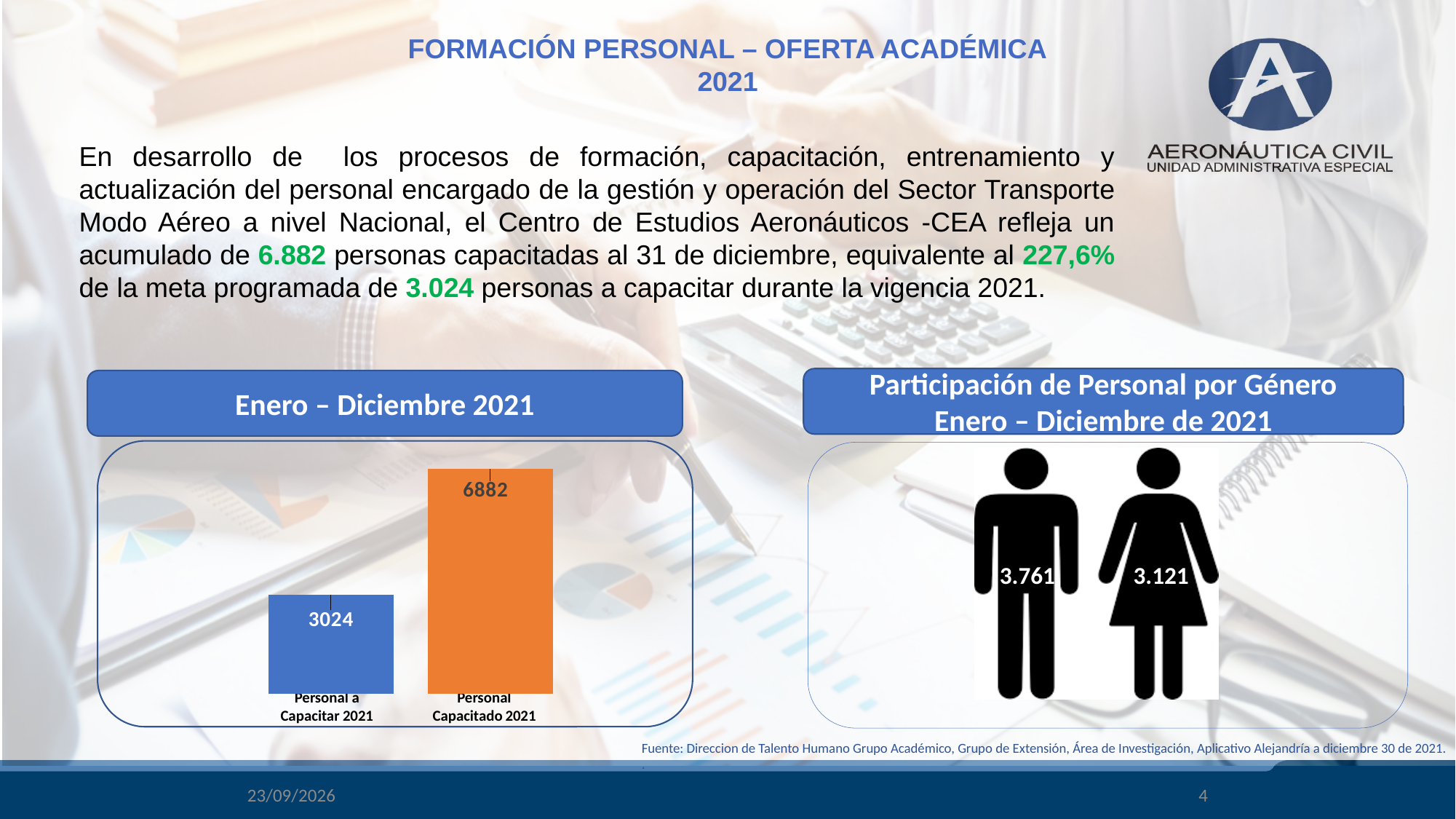
What type of chart is the 'Enero – Diciembre 2021' chart? Bar chart In the 'Enero – Diciembre 2021' chart, what is the value for Personal a Capacitar 2021? 3024 In the 'Enero – Diciembre 2021' chart, which category has the highest value? Personal Capacitado 2021 In the 'Enero – Diciembre 2021' chart, which category has the lowest value? Personal a Capacitar 2021 In the 'Enero – Diciembre 2021' chart, what colour is the bar for Personal Capacitado 2021? Orange In the 'Enero – Diciembre 2021' chart, which is larger: Personal a Capacitar 2021 or Personal Capacitado 2021? Personal Capacitado 2021 In the 'Participación de Personal por Género Enero – Diciembre de 2021' graphic, what is the value shown on the male figure? 3.761 In the 'Enero – Diciembre 2021' chart, what is the value for Personal Capacitado 2021? 6882 In the 'Participación de Personal por Género Enero – Diciembre de 2021' graphic, which figure shows the larger value, male or female? Male In the 'Enero – Diciembre 2021' chart, what is the difference between Personal Capacitado 2021 and Personal a Capacitar 2021? 3858 In the 'Participación de Personal por Género Enero – Diciembre de 2021' graphic, what is the value shown on the female figure? 3.121 How many bars are shown in the 'Enero – Diciembre 2021' chart? 2